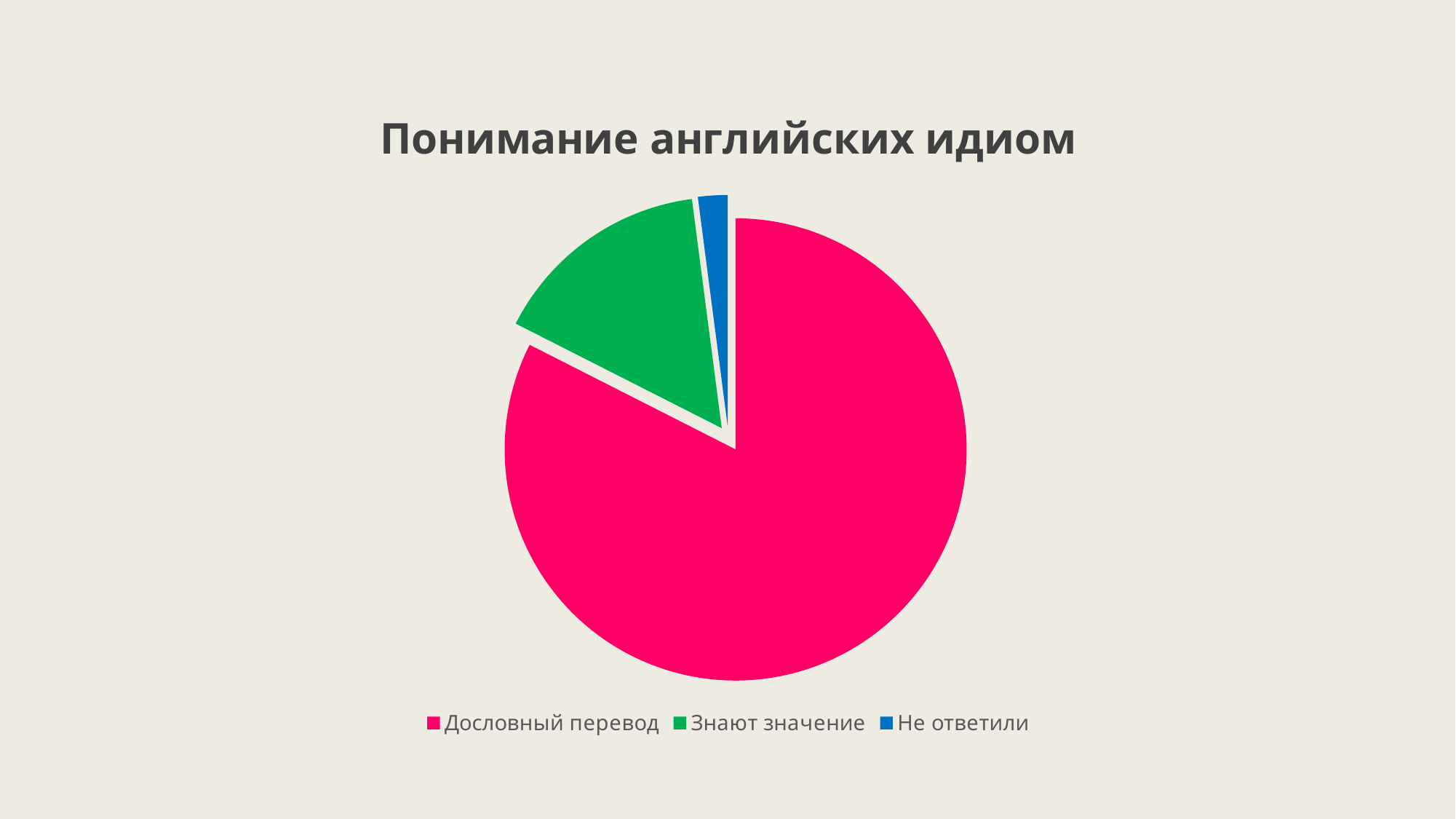
Does the slice for Дословный перевод take up more or less than half of the pie? more Which category has the smallest slice of the pie? Не ответили How many slices does the pie chart have? 3 How many entries does the legend list? 3 Which slice is larger: Дословный перевод or Знают значение? Дословный перевод Which slice is larger: Знают значение or Не ответили? Знают значение Which category has the largest slice of the pie? Дословный перевод What colour is the slice for Знают значение? green What kind of chart is shown on the slide? pie chart What is the title of the chart? Понимание английских идиом